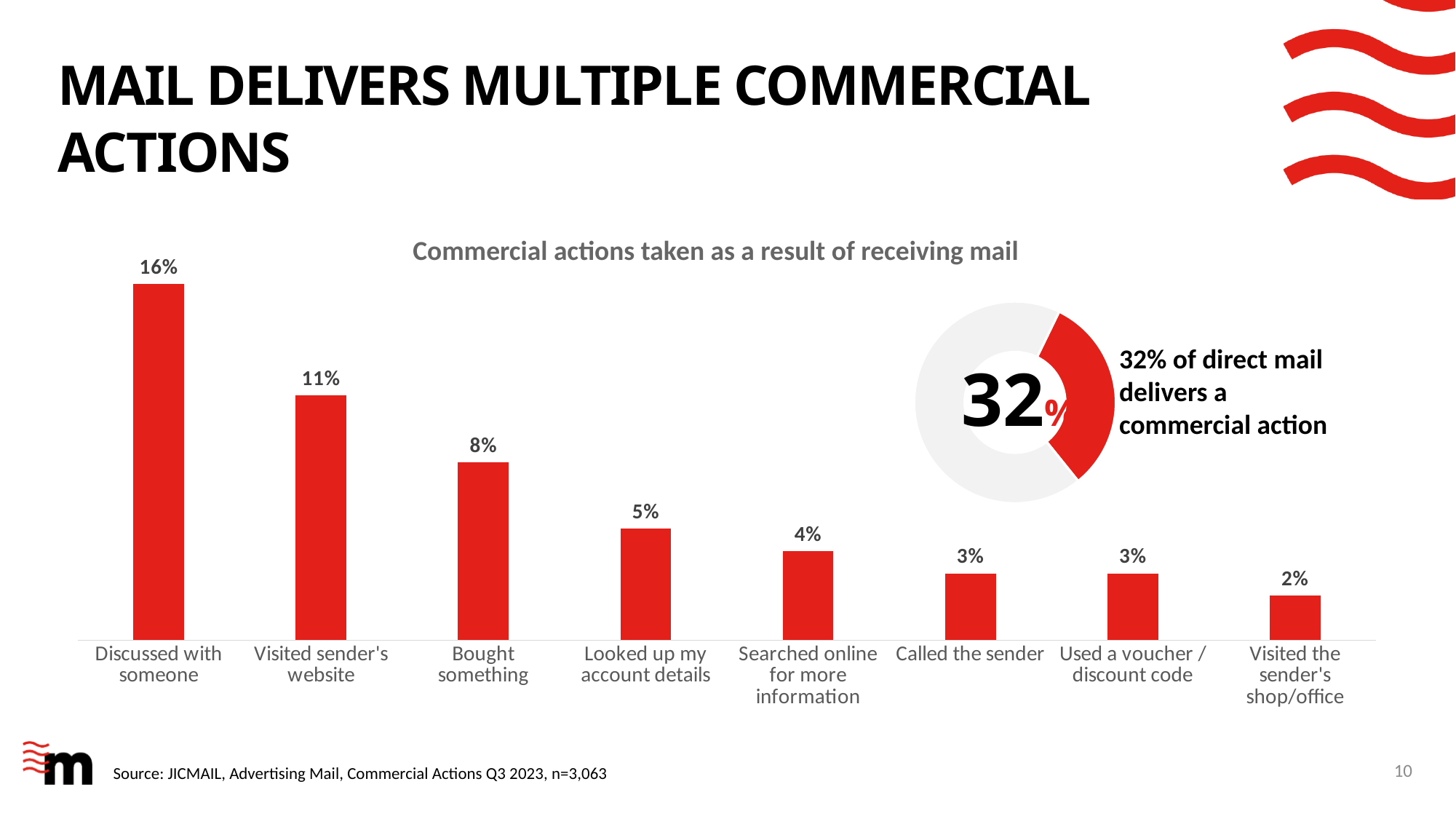
In the bar chart 'Commercial actions taken as a result of receiving mail', what is the value for 'Used a voucher / discount code'? 3% What colour are the bars in the bar chart 'Commercial actions taken as a result of receiving mail'? Red How many categories are shown in the bar chart 'Commercial actions taken as a result of receiving mail'? 8 In the bar chart 'Commercial actions taken as a result of receiving mail', which category has the lowest value? Visited the sender's shop/office In the bar chart 'Commercial actions taken as a result of receiving mail', what is the value for 'Visited sender's website'? 11% In the bar chart 'Commercial actions taken as a result of receiving mail', what is the difference between 'Discussed with someone' and 'Bought something'? 8% In the bar chart 'Commercial actions taken as a result of receiving mail', do the values rise or fall from left to right? Fall In the donut chart on the right of the slide, what share of direct mail delivers a commercial action? 32% In the bar chart 'Commercial actions taken as a result of receiving mail', which category has the highest value? Discussed with someone What kind of chart is 'Commercial actions taken as a result of receiving mail'? Bar chart In the bar chart 'Commercial actions taken as a result of receiving mail', which is larger: 'Looked up my account details' or 'Called the sender'? Looked up my account details In the bar chart 'Commercial actions taken as a result of receiving mail', what is the value for 'Searched online for more information'? 4%